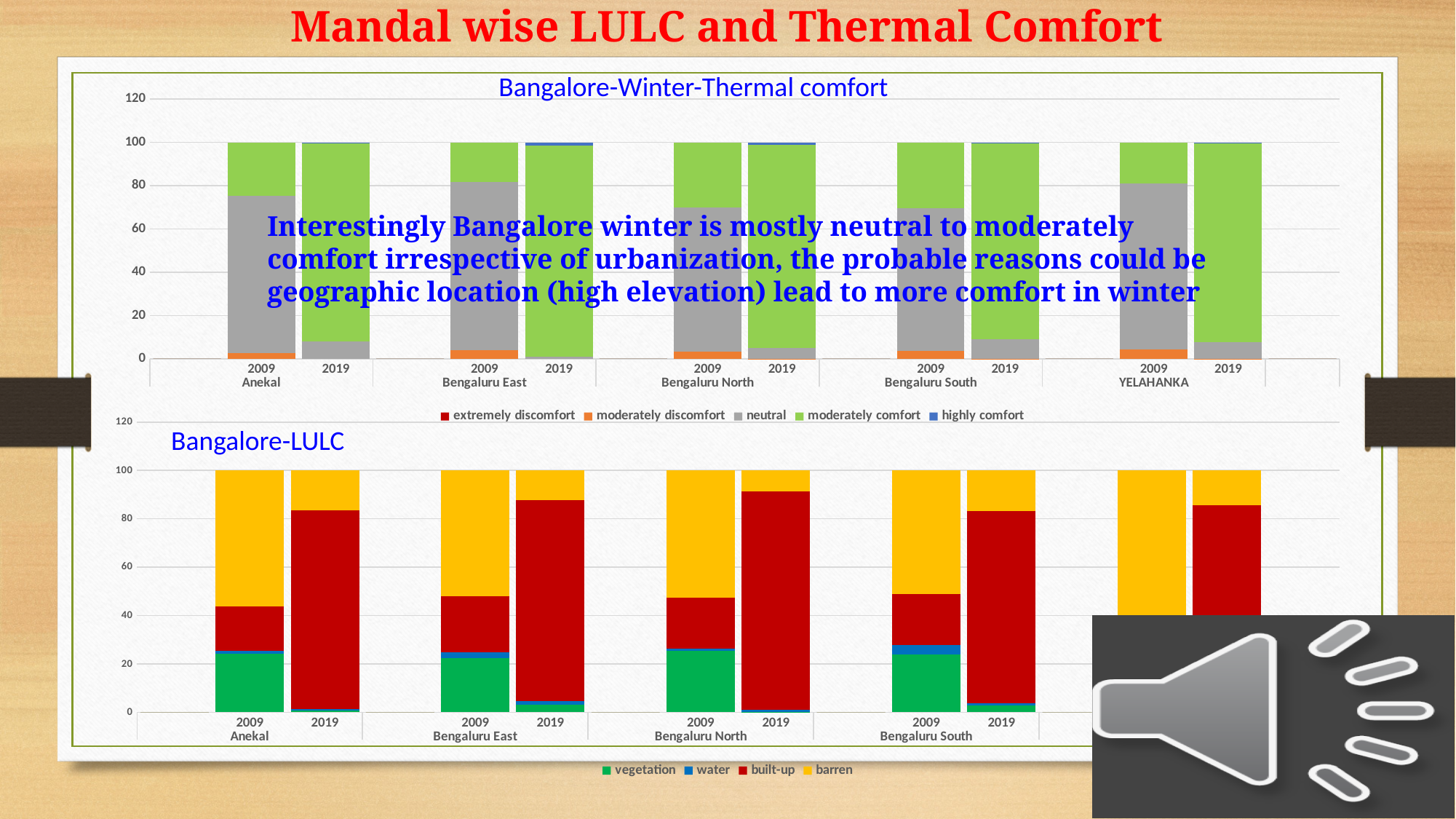
What kind of chart is the Bangalore-Winter-Thermal comfort chart at the top of the slide? Stacked bar chart In the Bangalore-Winter-Thermal comfort chart, is the moderately comfort share for Bengaluru East larger in 2009 or in 2019? 2019 How many series does the legend of the Bangalore-Winter-Thermal comfort chart list? 5 In the Bangalore-LULC chart, which colour represents built-up? Red In the Bangalore-Winter-Thermal comfort chart, which two years are compared for each mandal? 2009 and 2019 In the Bangalore-LULC chart, is the vegetation share for Bengaluru North larger in 2009 or in 2019? 2009 In the Bangalore-Winter-Thermal comfort chart, is the neutral share for Anekal larger in 2009 or in 2019? 2009 In the Bangalore-Winter-Thermal comfort chart, how many mandals are shown along the x axis? 5 How many series does the legend of the Bangalore-LULC chart list? 4 In the Bangalore-LULC chart, is the vegetation value for Bengaluru North 2009 greater or less than 20? greater In the Bangalore-LULC chart, is the top of the built-up segment for Bengaluru North 2019 greater or less than 80? greater